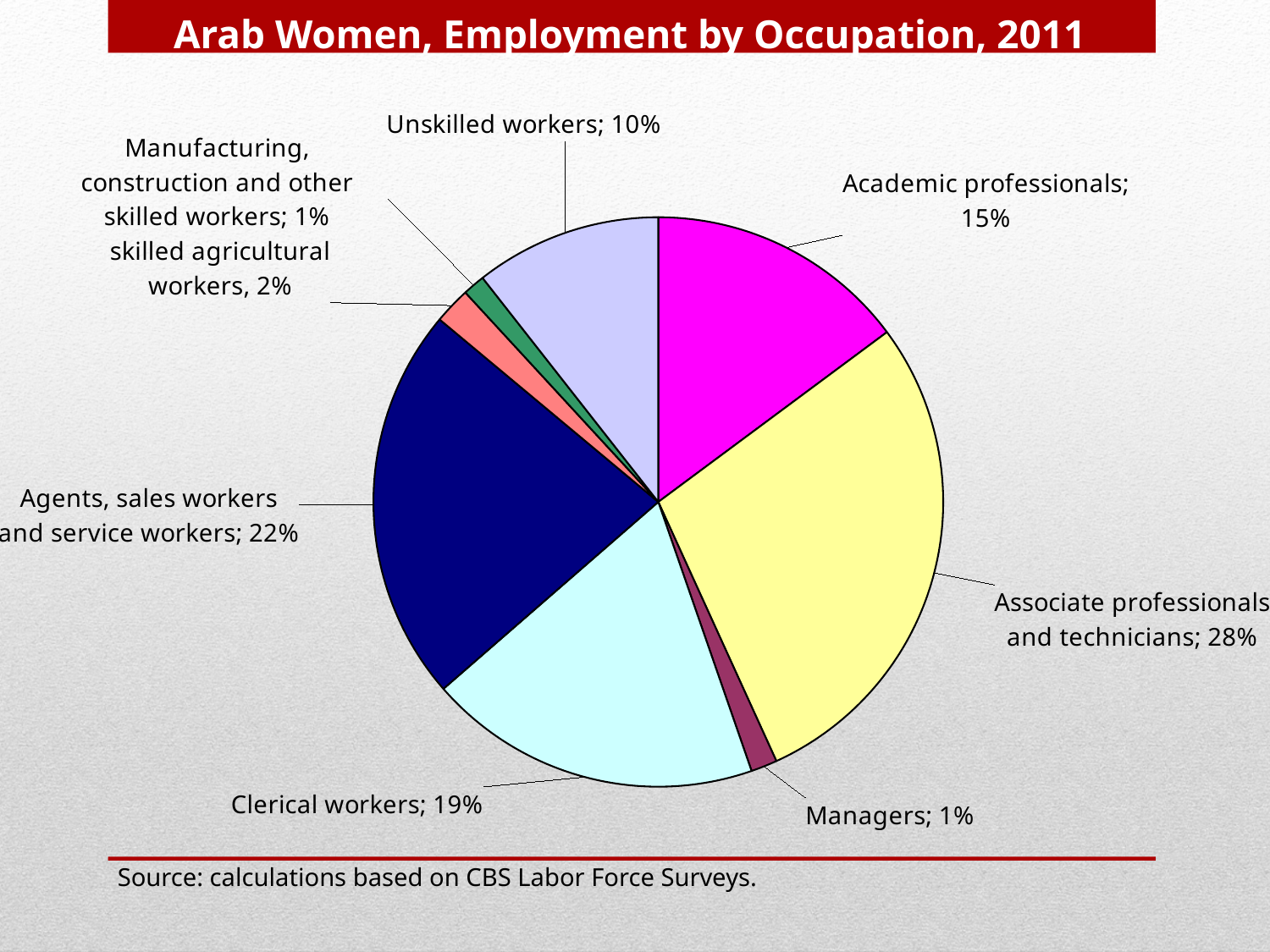
What is the value for skilled agricultural workers? 2% What is the title of the chart? Arab Women, Employment by Occupation, 2011 What is the value for Agents, sales workers and service workers? 22% What is the value for Unskilled workers? 10% Which is larger, the share for Academic professionals or the share for Unskilled workers? Academic professionals What is the value for Academic professionals? 15% How many slices does the pie chart have? 8 What share of the pie is Clerical workers? 19% What share of the pie is Associate professionals and technicians? 28% Which occupation has the largest share of the pie? Associate professionals and technicians What is the difference between the shares for Agents, sales workers and service workers and Clerical workers? 3% What type of chart is shown on the slide? pie chart